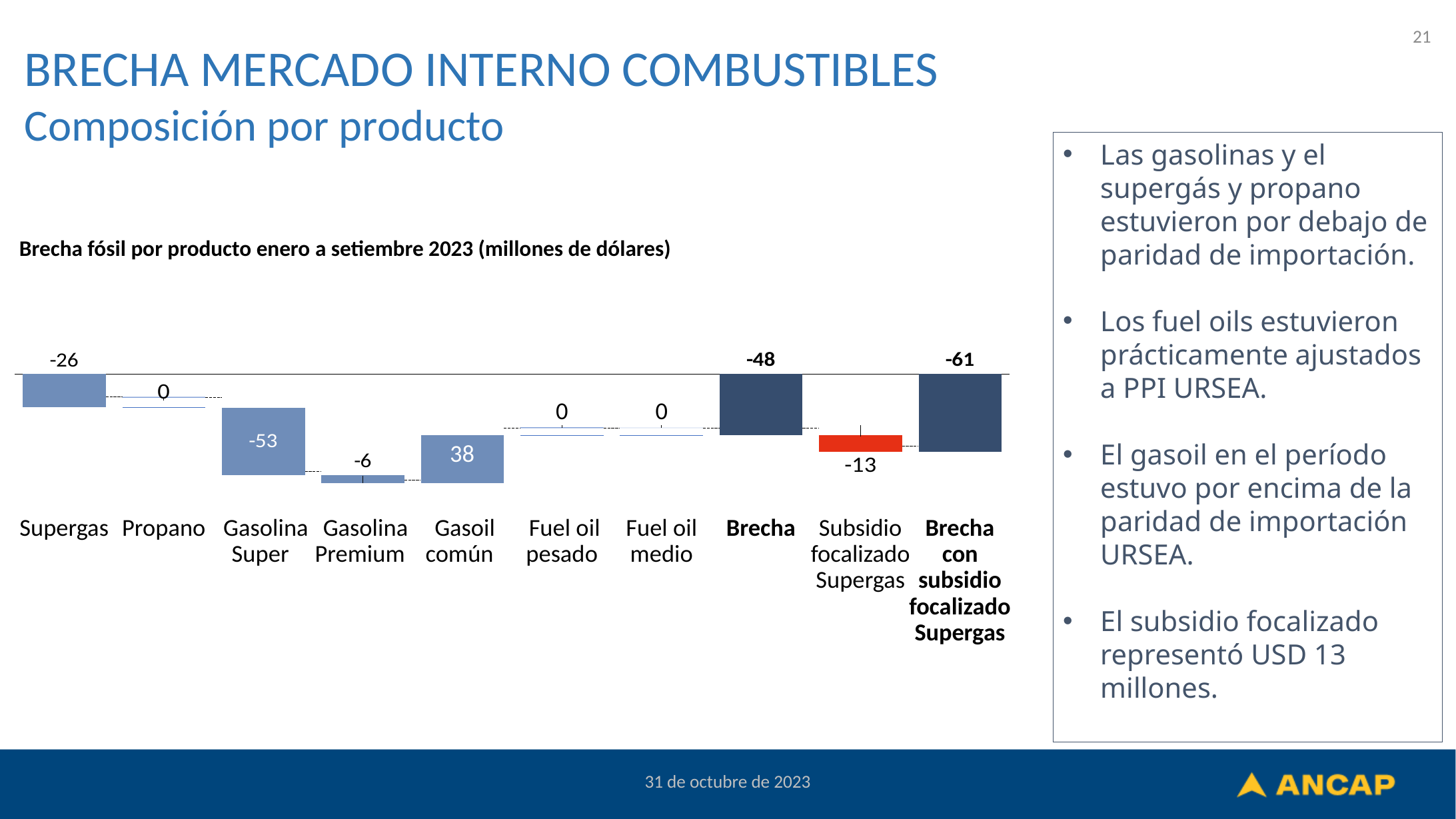
What is the value for Gasolina Super in the chart? -53 What kind of chart is shown on the slide? Bar chart (waterfall) What is the value for Subsidio focalizado Supergas? -13 What is the value for Supergas in the chart? -26 What is the title of the chart? Brecha fósil por producto enero a setiembre 2023 (millones de dólares) Which category has the highest value in the chart? Gasoil común Which is larger, the value for Supergas or the value for Gasolina Premium? Gasolina Premium What is the difference between the Brecha value and the Brecha con subsidio focalizado Supergas value? 13 What is the value for Gasoil común in the chart? 38 What is the value shown for Brecha con subsidio focalizado Supergas? -61 Which product has the lowest (most negative) value among the individual products? Gasolina Super How many categories are shown on the x axis of the chart? 10